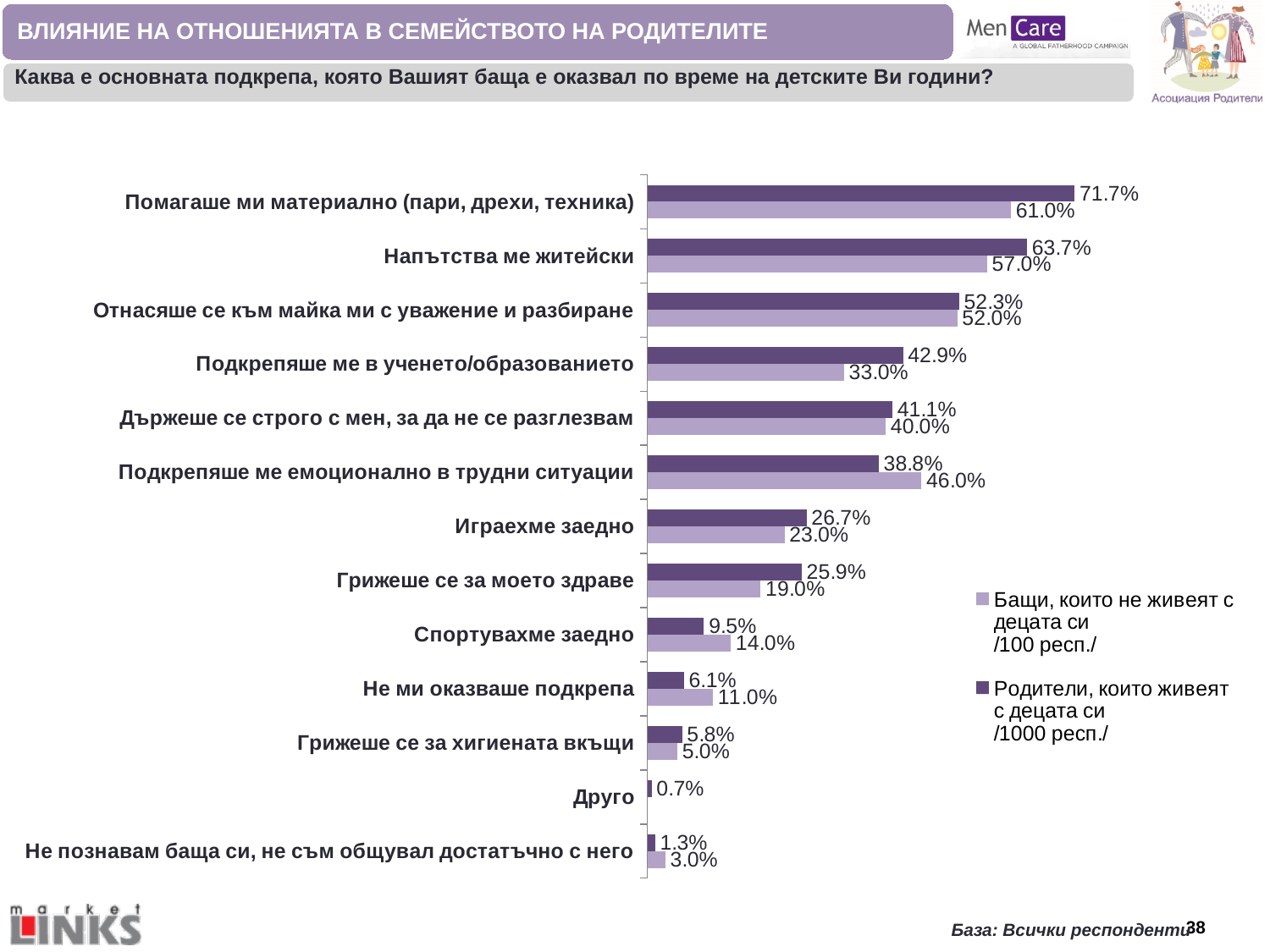
For "Играехме заедно", which series has the larger value? Родители, които живеят с децата си Which category has the highest value for the series "Родители, които живеят с децата си"? Помагаше ми материално (пари, дрехи, техника) What kind of chart is shown on the slide? bar chart Which category has the lowest value for the series "Родители, които живеят с децата си"? Друго How many series does the legend list? 2 What is the value for "Напътства ме житейски" for the series "Бащи, които не живеят с децата си"? 57.0% How many categories are shown on the chart? 13 What is the value for "Подкрепяше ме емоционално в трудни ситуации" for the series "Бащи, които не живеят с децата си"? 46.0% For "Спортувахме заедно", which series has the larger value? Бащи, които не живеят с децата си What is the difference between the two series for "Подкрепяше ме в ученето/образованието"? 9.9% What is the value for "Помагаше ми материално (пари, дрехи, техника)" for the series "Родители, които живеят с децата си"? 71.7% Which series is shown in the darker purple colour? Родители, които живеят с децата си /1000 респ./